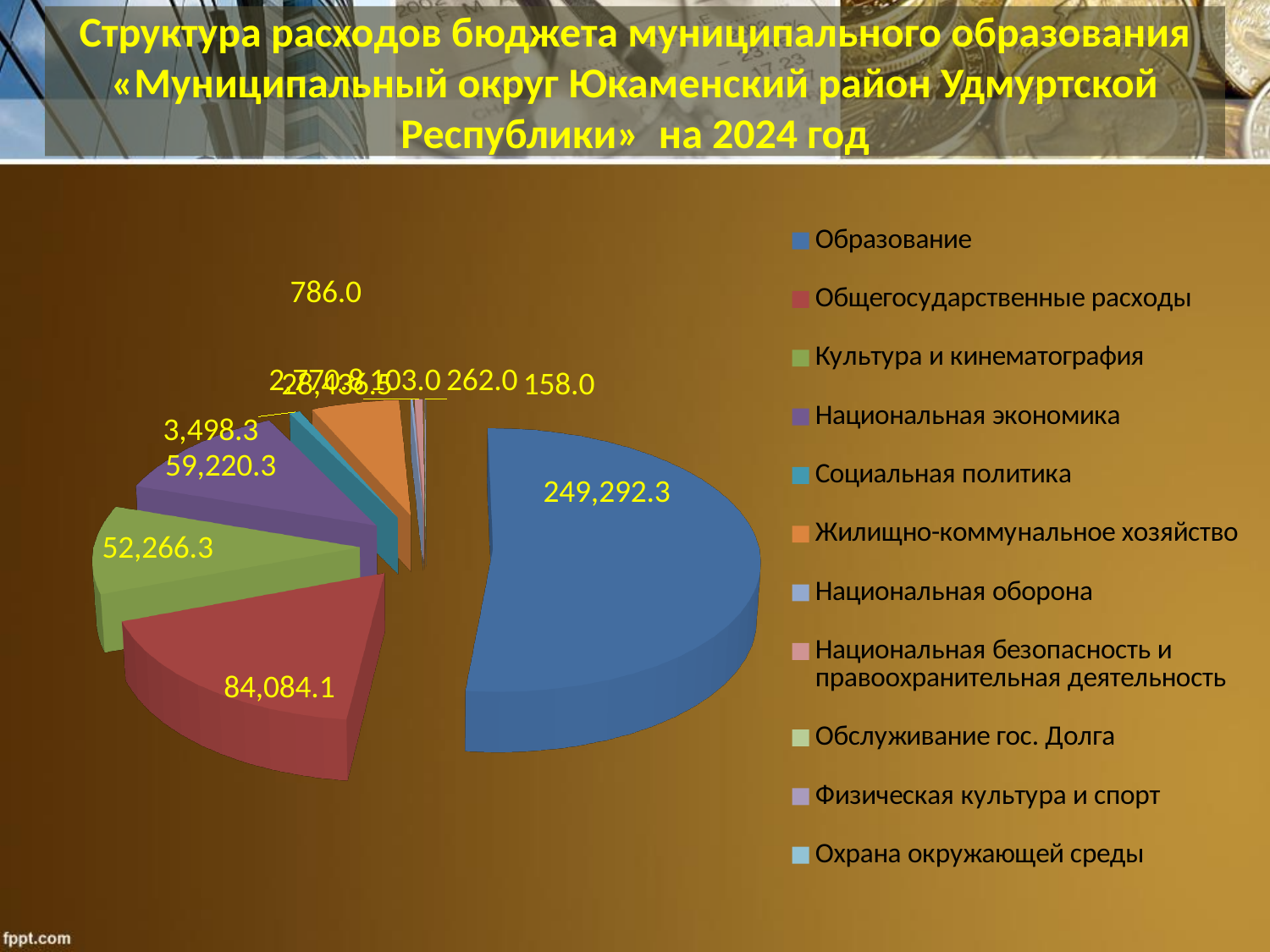
What colour is the slice for Общегосударственные расходы? Red Which category has the largest slice of the pie chart? Образование What is the difference between Общегосударственные расходы and Культура и кинематография? 31,817.8 Which is larger: Национальная экономика or Культура и кинематография? Национальная экономика What is the difference between Образование and Общегосударственные расходы? 165,208.2 What is the value shown for Культура и кинематография? 52,266.3 How many categories does the legend of the pie chart list? 11 What type of chart is shown on the slide? Pie chart What is the value shown for Национальная экономика? 59,220.3 What is the value shown for Общегосударственные расходы? 84,084.1 What is the value shown for Образование on the pie chart? 249,292.3 What is the difference between Национальная экономика and Культура и кинематография? 6,954.0